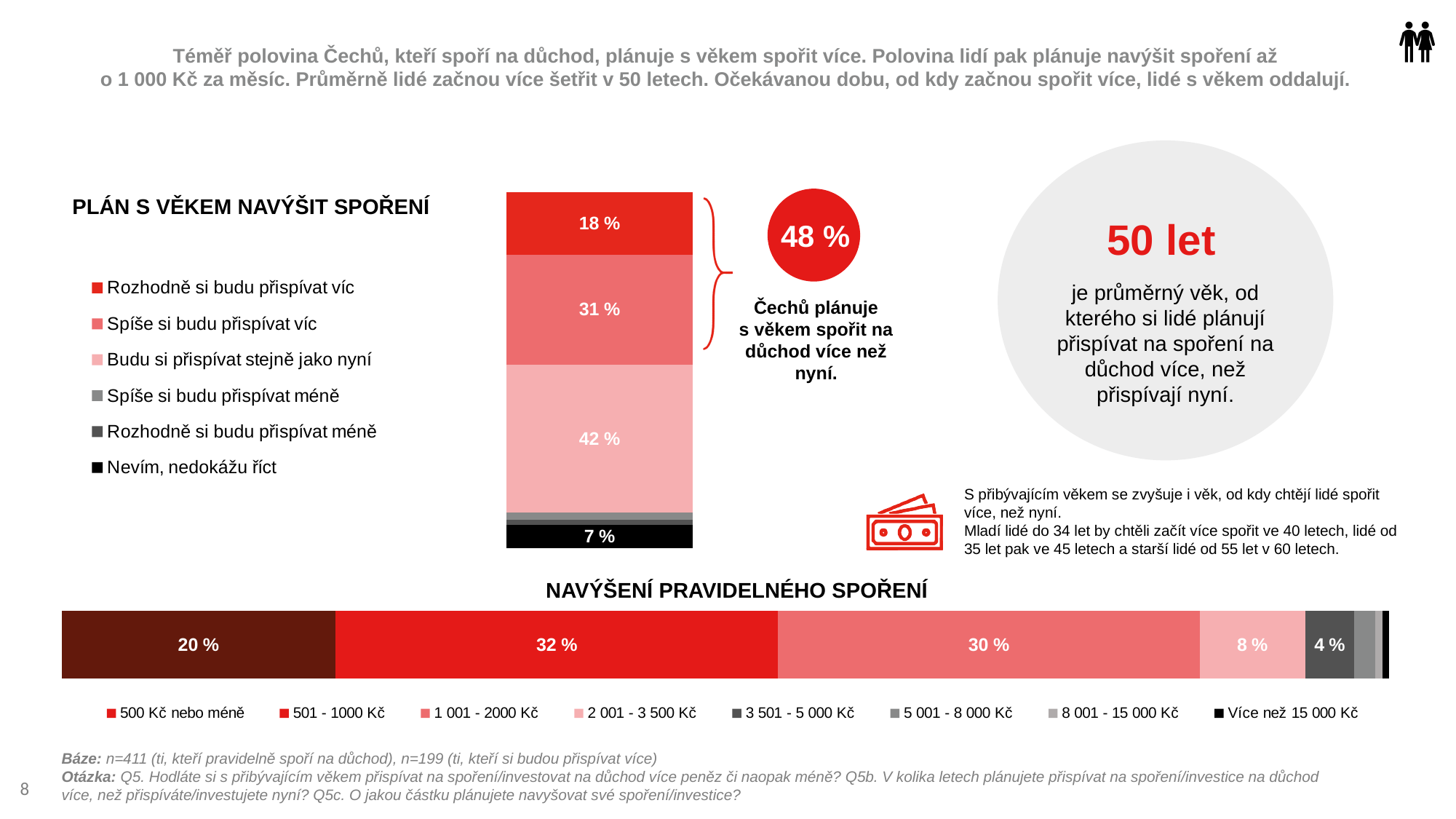
In the chart 'PLÁN S VĚKEM NAVÝŠIT SPOŘENÍ', how many entries does the legend list? 6 In the chart 'PLÁN S VĚKEM NAVÝŠIT SPOŘENÍ', what is the difference between 'Budu si přispívat stejně jako nyní' and 'Rozhodně si budu přispívat víc'? 24 % In the chart 'NAVÝŠENÍ PRAVIDELNÉHO SPOŘENÍ', which is larger: '1 001 - 2000 Kč' or '2 001 - 3 500 Kč'? 1 001 - 2000 Kč What type of chart is 'NAVÝŠENÍ PRAVIDELNÉHO SPOŘENÍ'? Stacked bar chart In the chart 'PLÁN S VĚKEM NAVÝŠIT SPOŘENÍ', what percentage is shown for 'Budu si přispívat stejně jako nyní'? 42 % In the chart 'NAVÝŠENÍ PRAVIDELNÉHO SPOŘENÍ', what percentage is shown for '500 Kč nebo méně'? 20 % In the chart 'PLÁN S VĚKEM NAVÝŠIT SPOŘENÍ', what percentage is shown for 'Spíše si budu přispívat víc'? 31 % In the chart 'NAVÝŠENÍ PRAVIDELNÉHO SPOŘENÍ', how many entries does the legend list? 8 In the chart 'PLÁN S VĚKEM NAVÝŠIT SPOŘENÍ', what percentage is shown for 'Nevím, nedokážu říct'? 7 % In the chart 'PLÁN S VĚKEM NAVÝŠIT SPOŘENÍ', what percentage is shown for 'Rozhodně si budu přispívat víc'? 18 % In the chart 'NAVÝŠENÍ PRAVIDELNÉHO SPOŘENÍ', what percentage is shown for '501 - 1000 Kč'? 32 % In the chart 'PLÁN S VĚKEM NAVÝŠIT SPOŘENÍ', which labelled segment has the largest share? Budu si přispívat stejně jako nyní